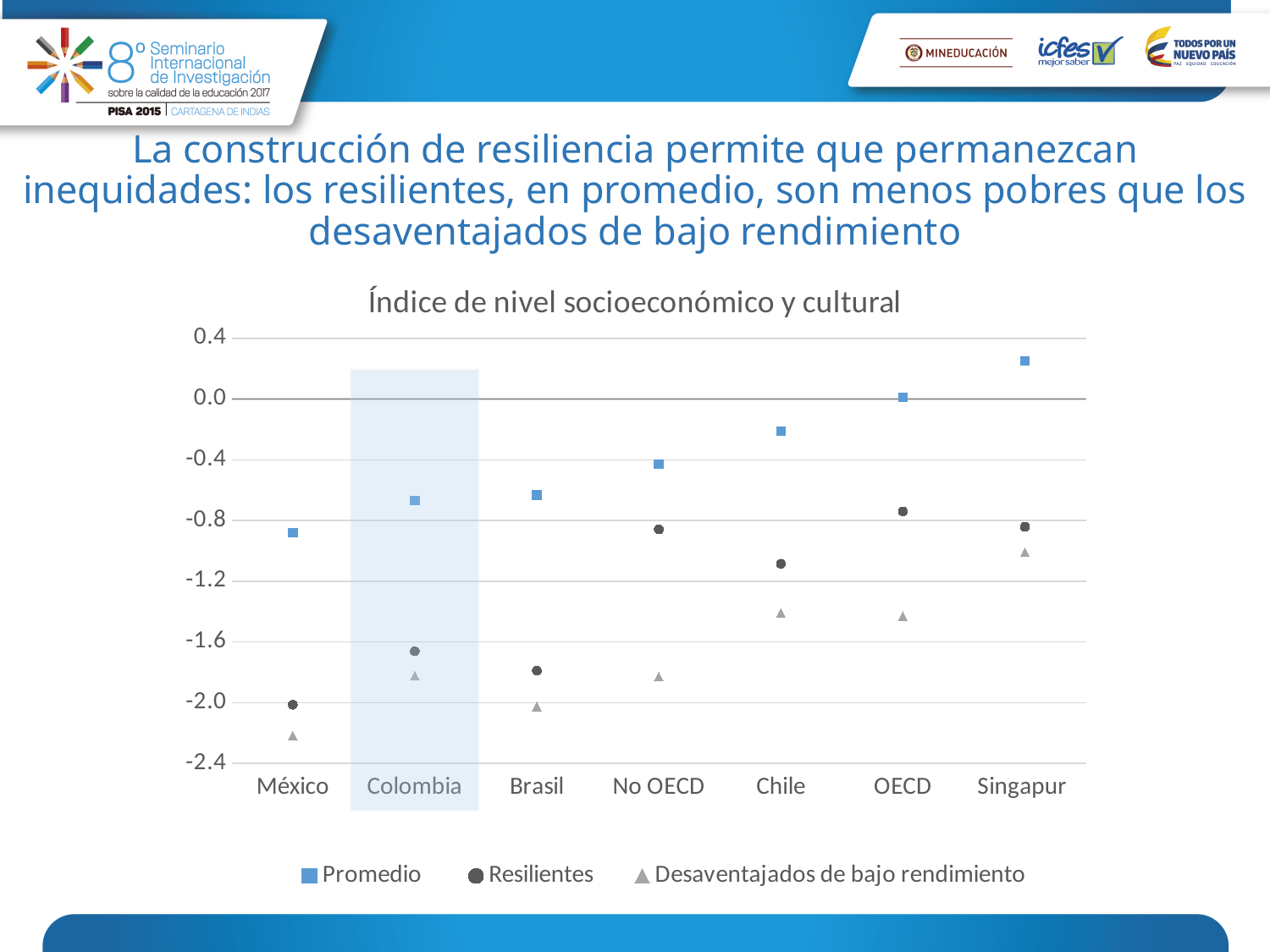
Which category has the highest value for the Desaventajados de bajo rendimiento series? Singapur Do the Promedio values rise or fall from México on the left to Singapur on the right? rise Which category has the lowest value for the Resilientes series? México Is the Promedio value for Singapur greater or less than 0.0? greater Is the Resilientes value for Chile greater or less than -1.2? greater Is the Promedio value for México greater or less than -0.8? less Which has the larger Resilientes value, Colombia or Brasil? Colombia Which category has the lowest value for the Promedio series? México Which category has the lowest value for the Desaventajados de bajo rendimiento series? México Which category has the highest value for the Promedio series? Singapur How many categories are shown on the x axis? 7